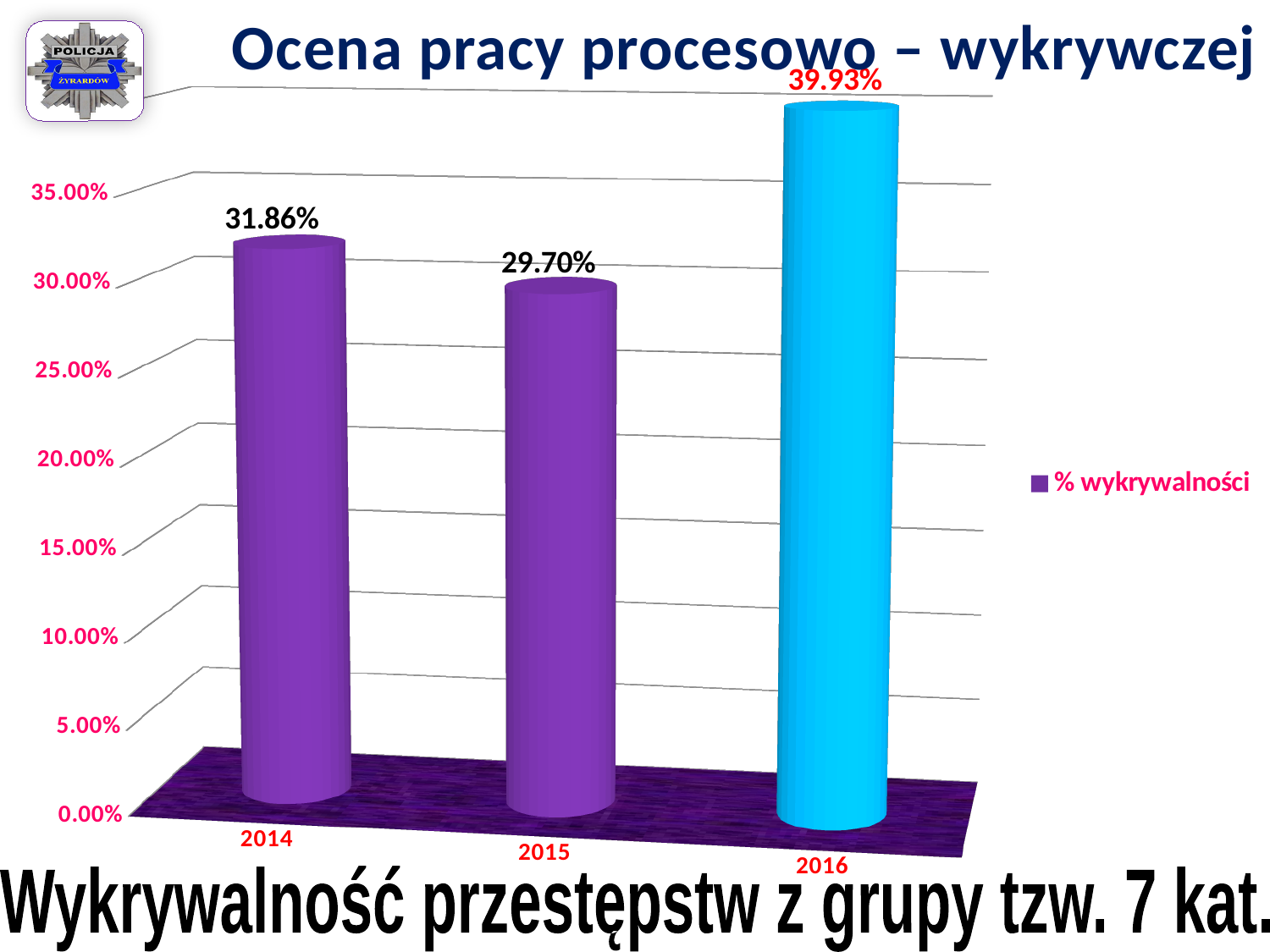
Which year has the lowest % wykrywalności? 2015 What is the difference between the 2016 and 2015 values? 10.23% Which is larger, the value for 2014 or the value for 2016? 2016 What is the % wykrywalności value for 2015? 29.70% What is the difference between the 2014 and 2015 values? 2.16% Is the value for 2016 greater or less than 35.00%? greater What kind of chart is shown on the slide? Bar chart What is the % wykrywalności value for 2016? 39.93% How many years are shown on the chart? 3 What is the % wykrywalności value for 2014? 31.86% How many series does the legend list? 1 Which year has the highest % wykrywalności? 2016